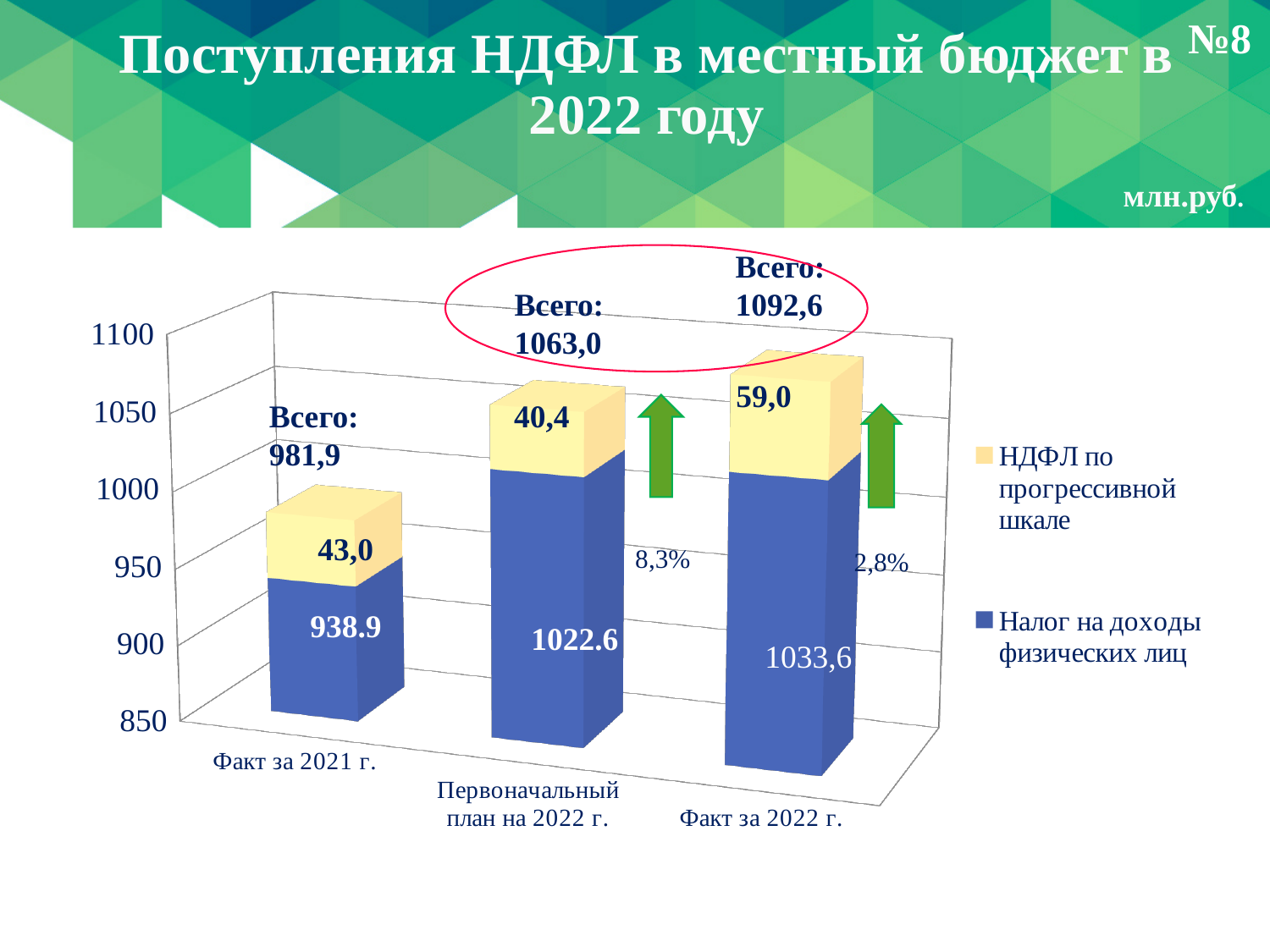
Which category has the highest value for the 'НДФЛ по прогрессивной шкале' series? Факт за 2022 г. What is the value of the 'Налог на доходы физических лиц' series for 'Первоначальный план на 2022 г.'? 1022.6 What is the value of the 'Налог на доходы физических лиц' series for 'Факт за 2021 г.'? 938.9 How many categories are shown on the x axis of the chart? 3 What is the value of the 'НДФЛ по прогрессивной шкале' series for 'Первоначальный план на 2022 г.'? 40,4 What is the total ('Всего') shown for 'Факт за 2022 г.'? 1092,6 What is the difference between the 'НДФЛ по прогрессивной шкале' values for 'Факт за 2022 г.' and 'Первоначальный план на 2022 г.'? 18,6 Which is larger: the 'Налог на доходы физических лиц' value for 'Факт за 2022 г.' or for 'Первоначальный план на 2022 г.'? Факт за 2022 г. Which category has the lowest value for the 'Налог на доходы физических лиц' series? Факт за 2021 г. What is the total ('Всего') shown for 'Факт за 2021 г.'? 981,9 What is the value of the 'НДФЛ по прогрессивной шкале' series for 'Факт за 2022 г.'? 59,0 How many series does the chart legend list? 2